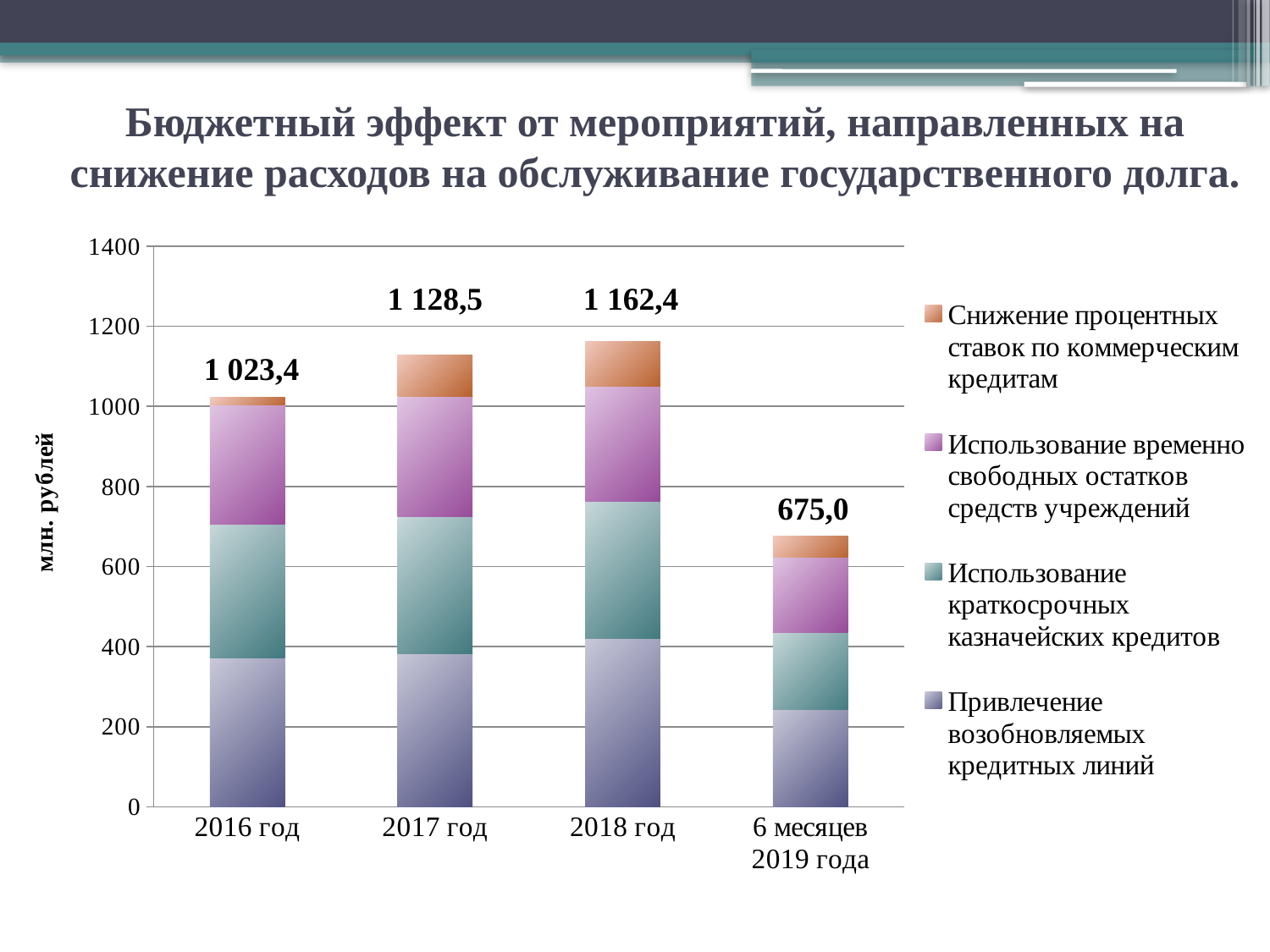
What kind of chart is shown on the slide? Stacked bar chart What is the difference between the totals for 2017 год and 2016 год? 105,1 What is the total value shown for 2016 год? 1 023,4 Which category has the lowest total value? 6 месяцев 2019 года What is the difference between the totals for 2018 год and 2017 год? 33,9 Which category has the highest total value? 2018 год Is the value of the Привлечение возобновляемых кредитных линий segment for 2016 год greater or less than 400? less How many categories are shown on the x axis? 4 How many series does the legend list? 4 Which total is larger, 2017 год or 2016 год? 2017 год What is the total value shown for 2018 год? 1 162,4 What is the total value shown for 6 месяцев 2019 года? 675,0